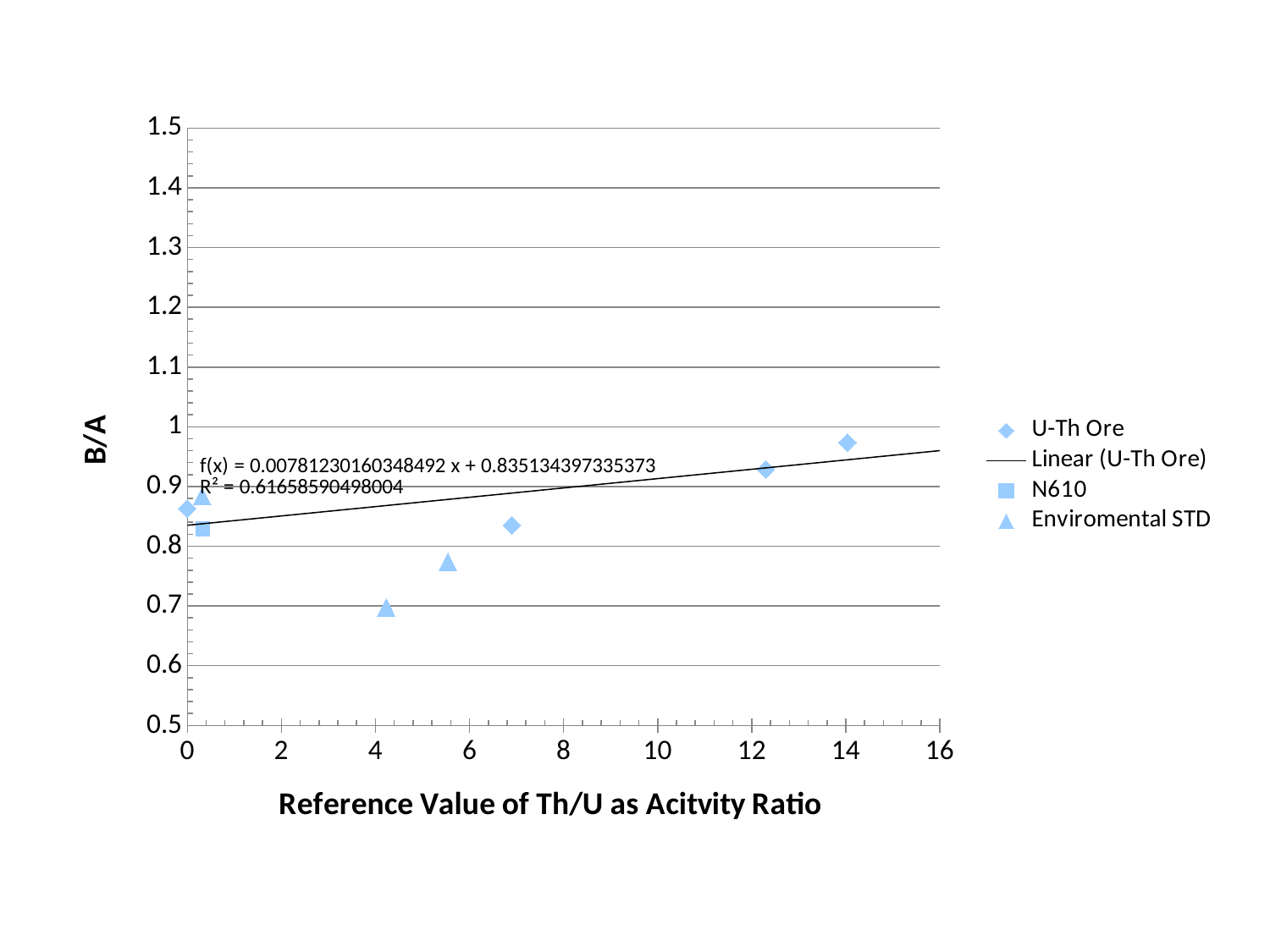
What is the R² value printed on the chart? 0.61658590498004 Does the linear trendline for U-Th Ore rise or fall as the reference value increases? rises Which series contains the highest plotted B/A value? U-Th Ore How many N610 data points are plotted? 1 How many series does the legend list? 4 Which series contains the lowest plotted B/A value? Enviromental STD What kind of chart is shown on the slide? scatter chart How many U-Th Ore data points are plotted? 4 Is the B/A value for the U-Th Ore point at a reference value of about 14 greater or less than 0.9? greater How many Enviromental STD data points are plotted? 3 Is the B/A value for the Enviromental STD point at a reference value of about 5.5 greater or less than 0.8? less What is the title of the x axis? Reference Value of Th/U as Acitvity Ratio